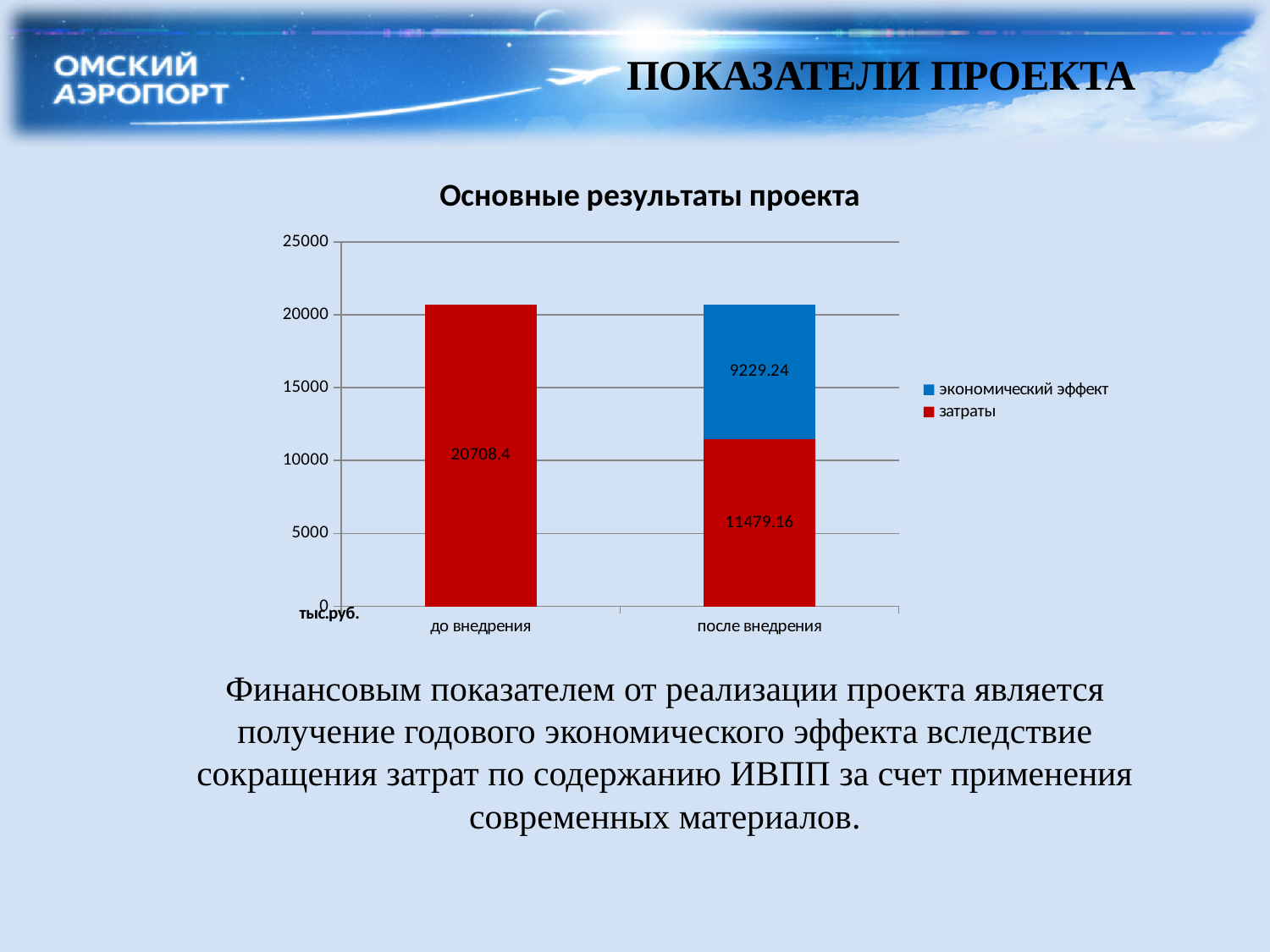
How many categories are shown on the x axis? 2 Is the value of затраты for после внедрения greater or less than 15000? less What is the total of the stacked bar for после внедрения? 20708.4 Which colour represents экономический эффект in the chart? Blue What type of chart is shown on the slide? Stacked bar chart What is the value of затраты for до внедрения? 20708.4 What is the value of экономический эффект for после внедрения? 9229.24 What is the title of the chart? Основные результаты проекта What is the value of затраты for после внедрения? 11479.16 By how much did затраты decrease from до внедрения to после внедрения? 9229.24 How many series does the legend list? 2 Which category has the higher value of затраты? до внедрения